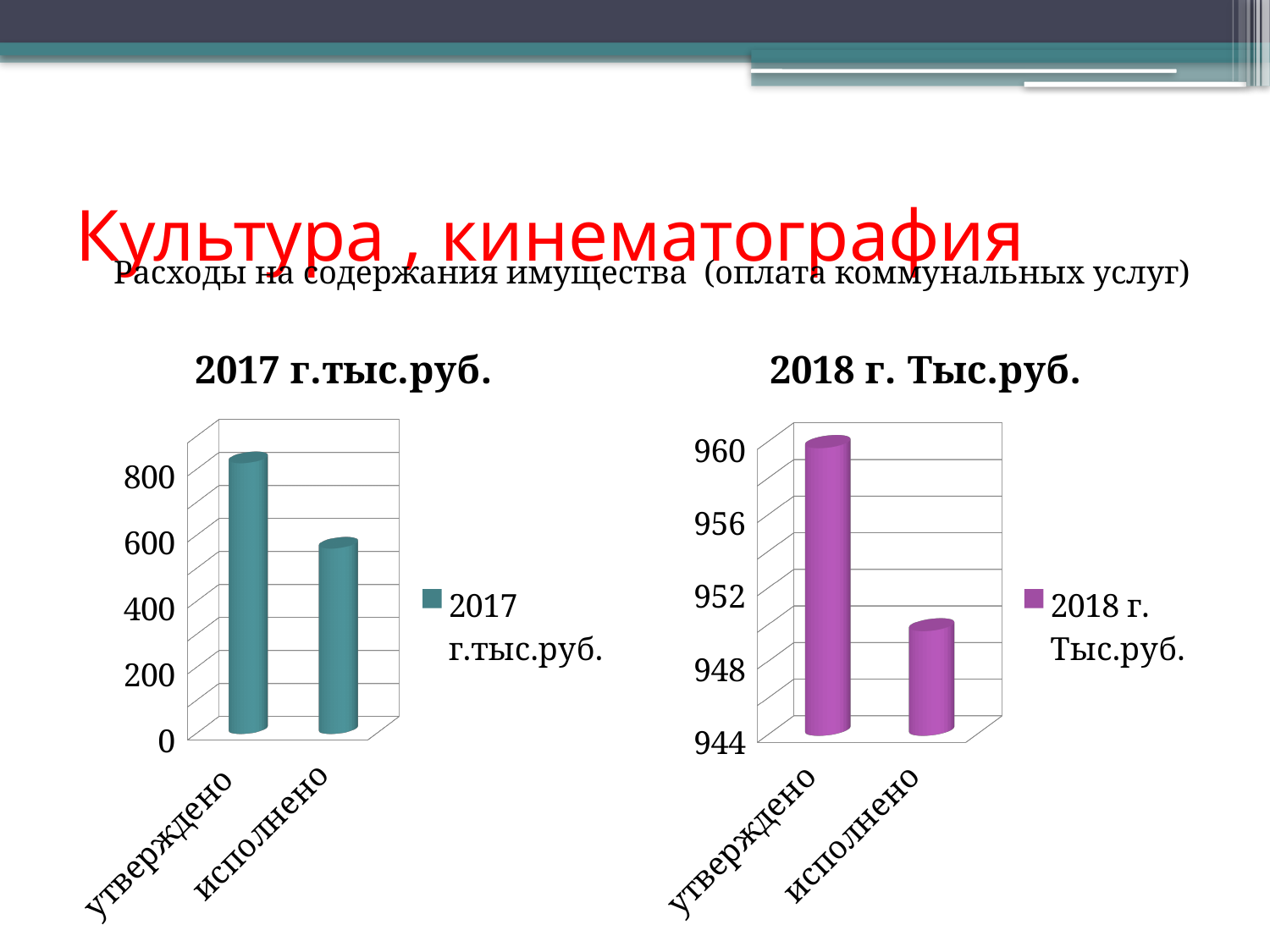
On the 2018 г. Тыс.руб. chart, is the value for утверждено greater or less than 956? greater How many categories are shown on the 2017 г.тыс.руб. chart? 2 What is the legend entry on the 2017 г.тыс.руб. chart? 2017 г.тыс.руб. How many series does the legend of the 2018 г. Тыс.руб. chart list? 1 On the 2018 г. Тыс.руб. chart, is the value for исполнено greater or less than 952? less On the 2017 г.тыс.руб. chart, which category has the lowest value? исполнено On the 2018 г. Тыс.руб. chart, which is larger, утверждено or исполнено? утверждено On the 2017 г.тыс.руб. chart, is the value for утверждено greater or less than 600? greater On the 2017 г.тыс.руб. chart, which category has the highest value? утверждено On the 2018 г. Тыс.руб. chart, which category has the highest value? утверждено What kind of chart is the 2017 г.тыс.руб. chart? bar chart